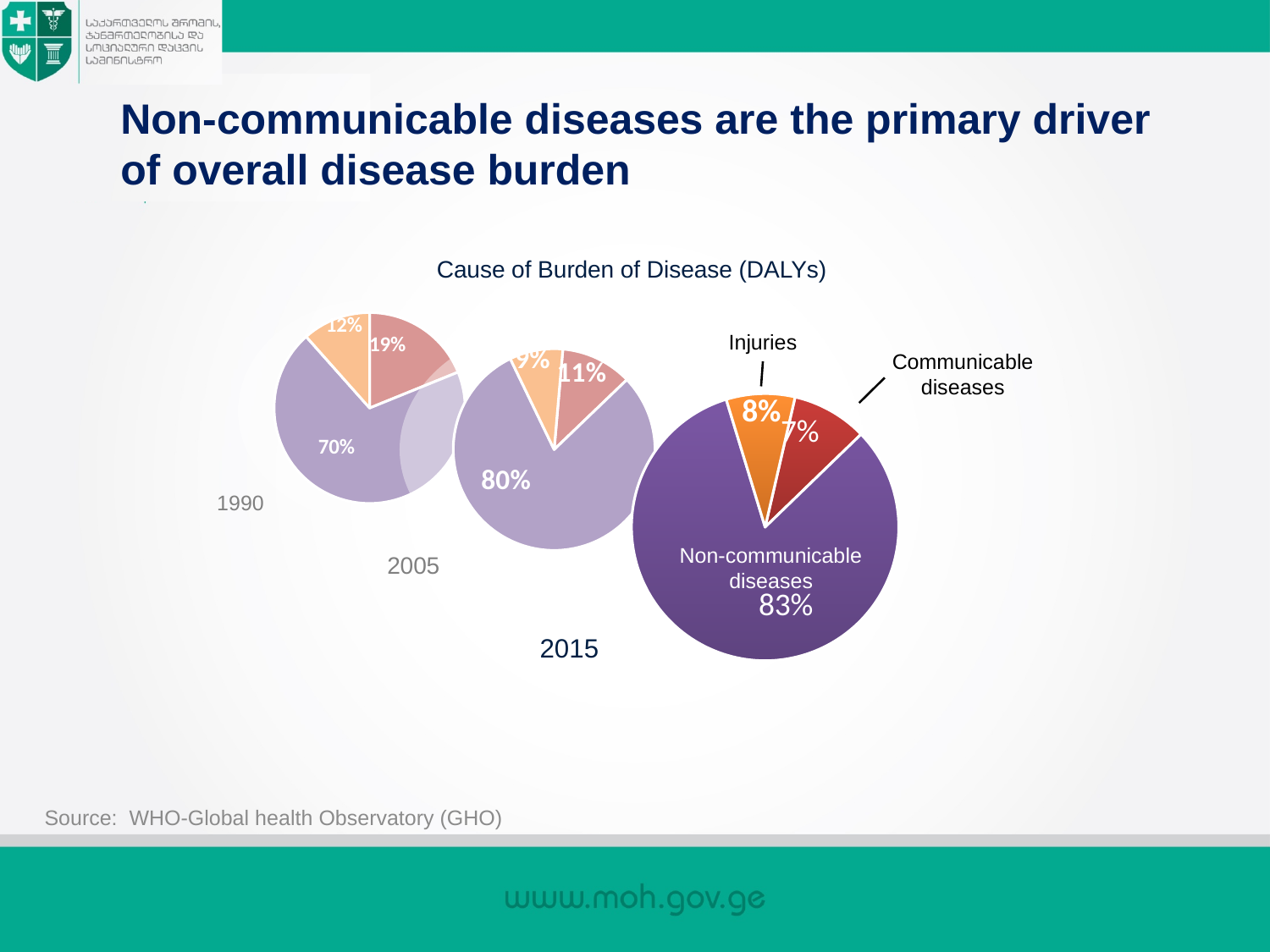
In the 2015 pie chart, what share is attributed to injuries? 8% How many pie charts are shown on the slide? 3 In the 2015 pie chart, which category has the smallest slice? Communicable diseases What is the largest percentage shown in the 1990 pie chart? 70% How does the largest slice change from the 1990 pie chart to the 2015 pie chart? It rises (70% to 83%) What kind of charts are shown on the slide under the title 'Cause of Burden of Disease (DALYs)'? Pie charts In the 2015 pie chart, how many slices are there? 3 In the 2015 pie chart, what share of the burden of disease is attributed to non-communicable diseases? 83% In the 2015 pie chart, what share is attributed to communicable diseases? 7% In the 2015 pie chart, which category has the largest slice? Non-communicable diseases What is the largest percentage shown in the 2005 pie chart? 80% What is the difference between the largest slice in the 2015 pie chart and the largest slice in the 1990 pie chart? 13 percentage points